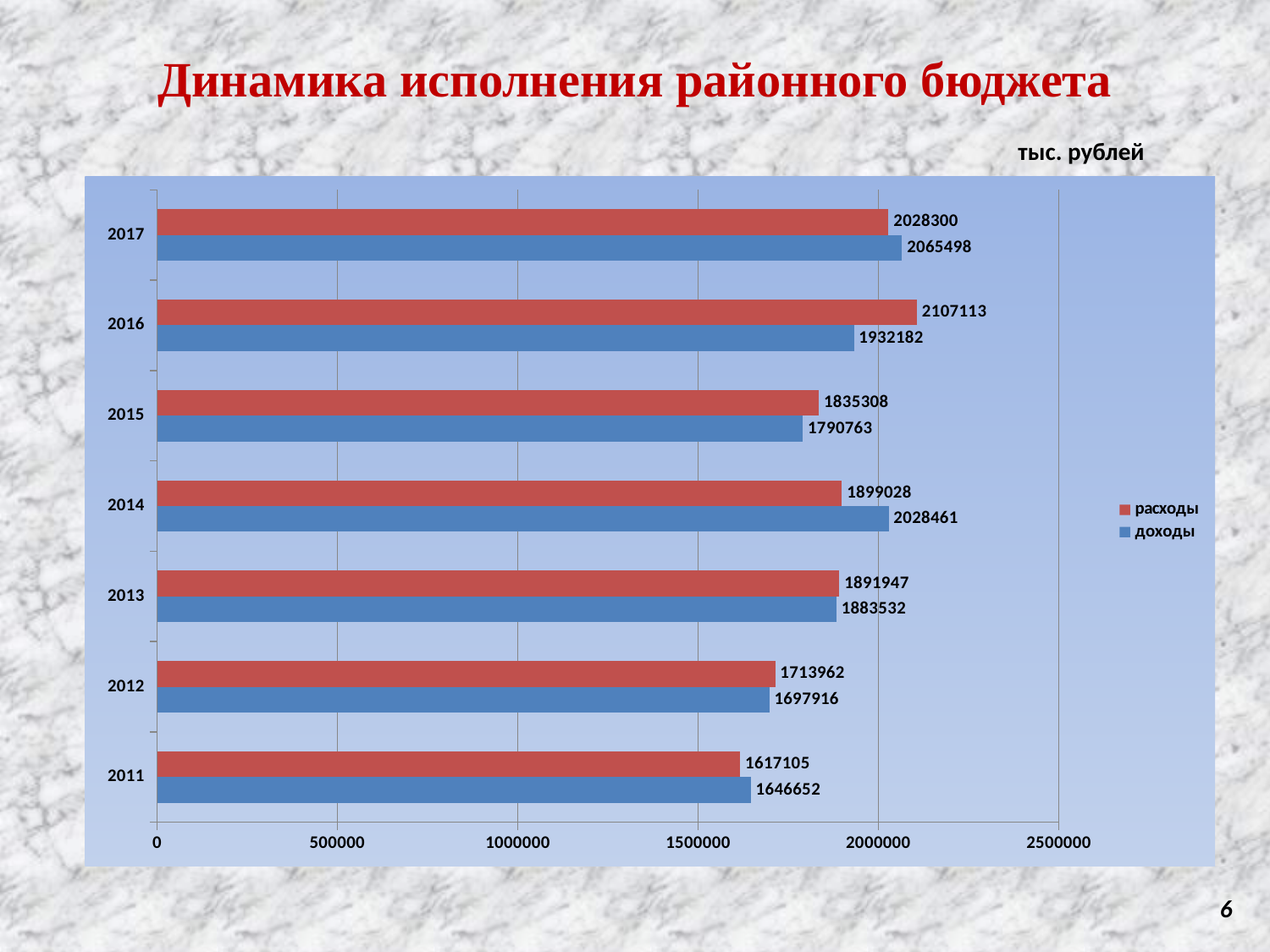
Is the value of расходы for 2011 greater or less than 2000000? less What is the value of расходы for 2016? 2107113 In which year are доходы the highest? 2017 How many years are shown on the chart? 7 What is the difference between расходы and доходы in 2016? 174931 In 2014, which is larger: расходы or доходы? доходы What is the value of доходы for 2014? 2028461 In which year are доходы the lowest? 2011 What type of chart is shown on the slide? bar chart What is the value of доходы for 2011? 1646652 In which year are расходы the highest? 2016 How many series does the legend list? 2